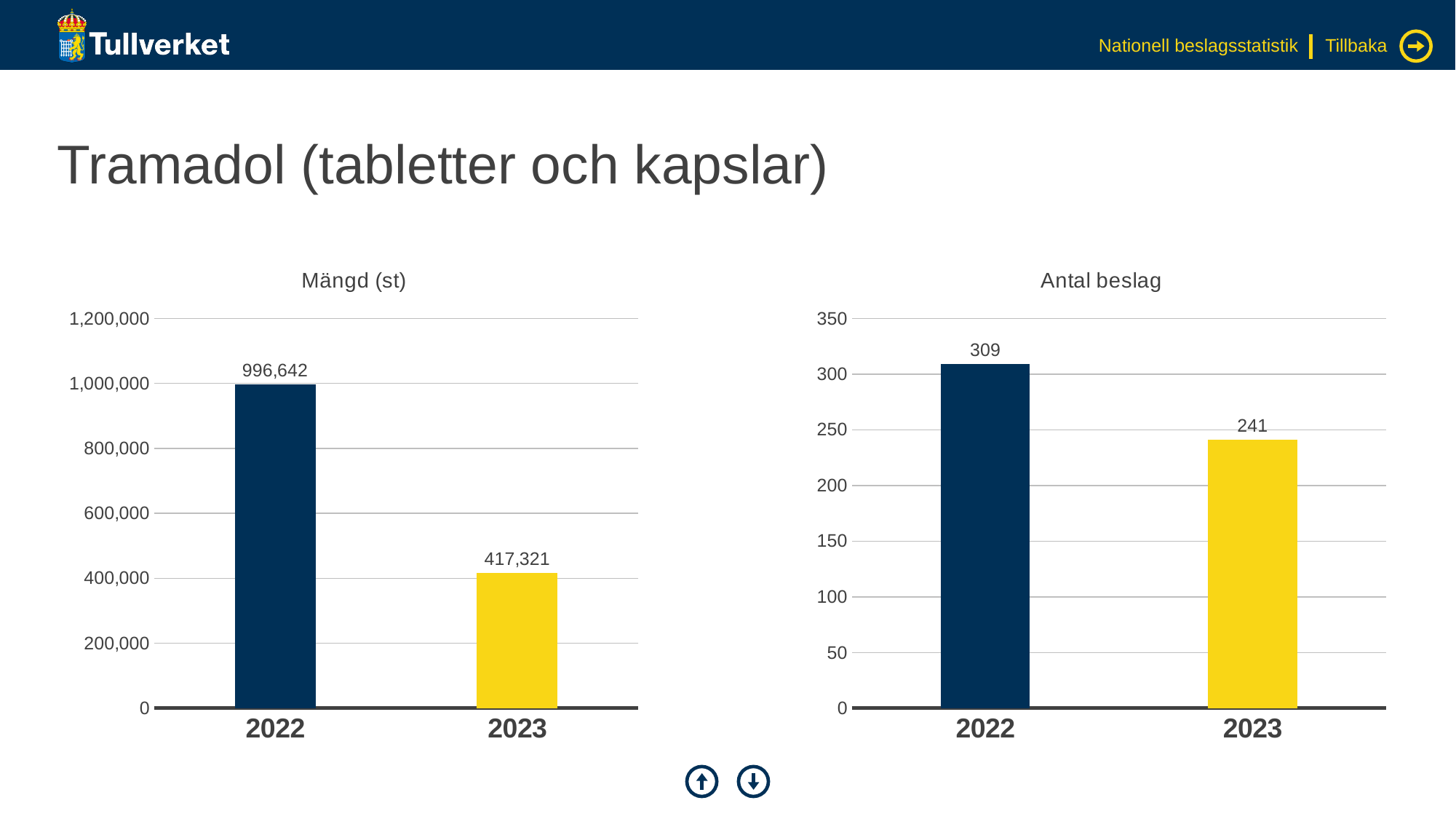
In the "Mängd (st)" chart, which year has the highest value? 2022 In the "Mängd (st)" chart, what is the value for 2022? 996,642 What kind of chart is the "Antal beslag" chart? bar chart In the "Antal beslag" chart, is the value for 2022 larger or smaller than the value for 2023? larger In the "Mängd (st)" chart, what is the difference between the 2022 and 2023 values? 579,321 In the "Antal beslag" chart, what is the value for 2022? 309 In the "Mängd (st)" chart, is the value for 2023 greater or less than 600,000? less In the "Antal beslag" chart, do the values rise or fall from 2022 to 2023? fall In the "Mängd (st)" chart, what is the value for 2023? 417,321 In the "Antal beslag" chart, what is the value for 2023? 241 In the "Antal beslag" chart, which year has the lowest value? 2023 In the "Antal beslag" chart, what is the difference between the 2022 and 2023 values? 68